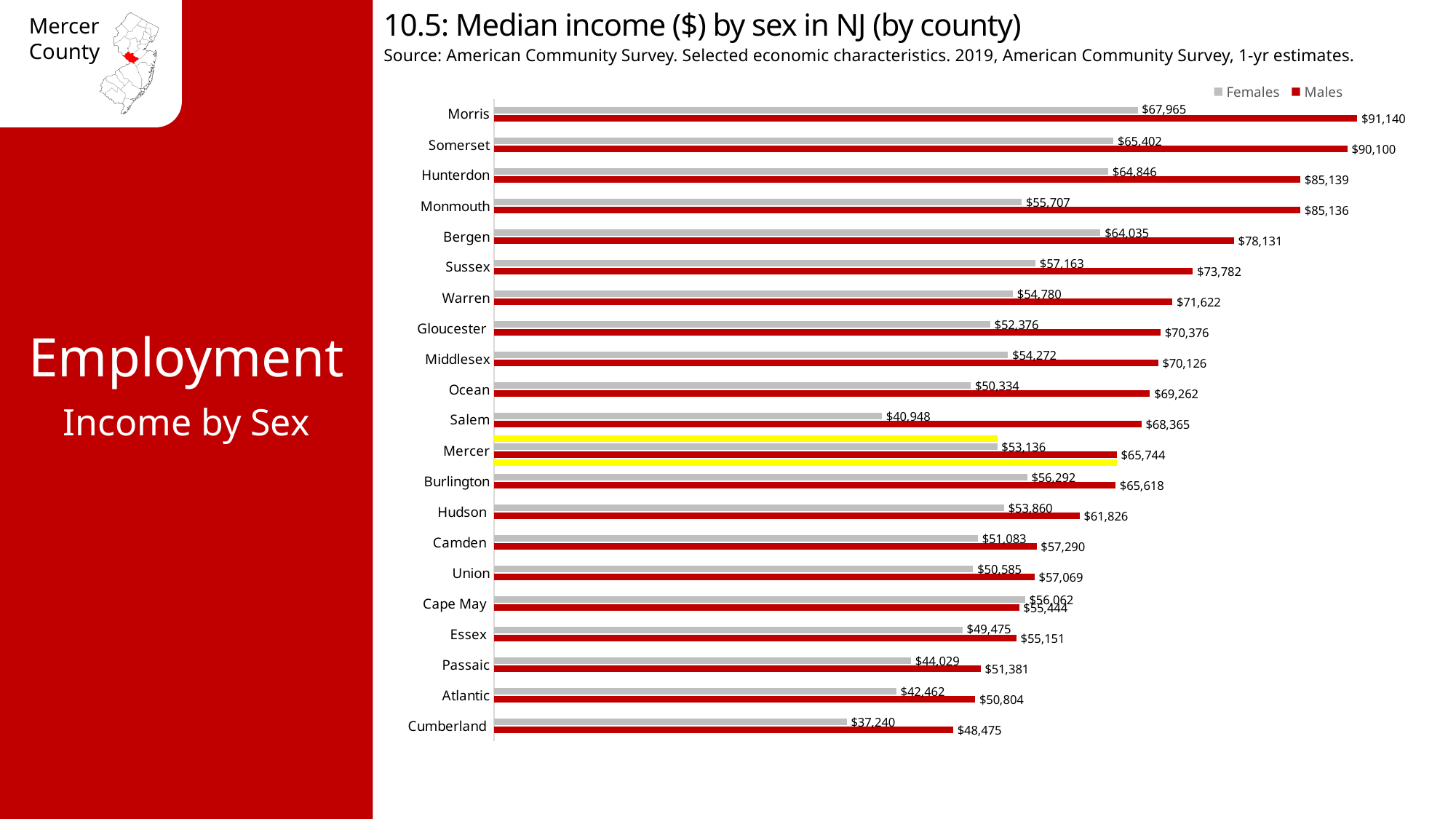
What is the difference between male and female median income in Mercer County? $12,608 What is the median income for females in Mercer County? $53,136 What type of chart is shown on the slide? Bar chart Which county has the highest median income for females? Morris What is the median income for females in Cumberland County? $37,240 In Cape May County, which is higher: the median income for females or for males? Females Which county has the lowest median income for males? Cumberland How many counties are shown in the chart? 21 How many series does the legend list? 2 What is the difference between male and female median income in Morris County? $23,175 What is the median income for males in Morris County? $91,140 What is the median income for males in Mercer County? $65,744